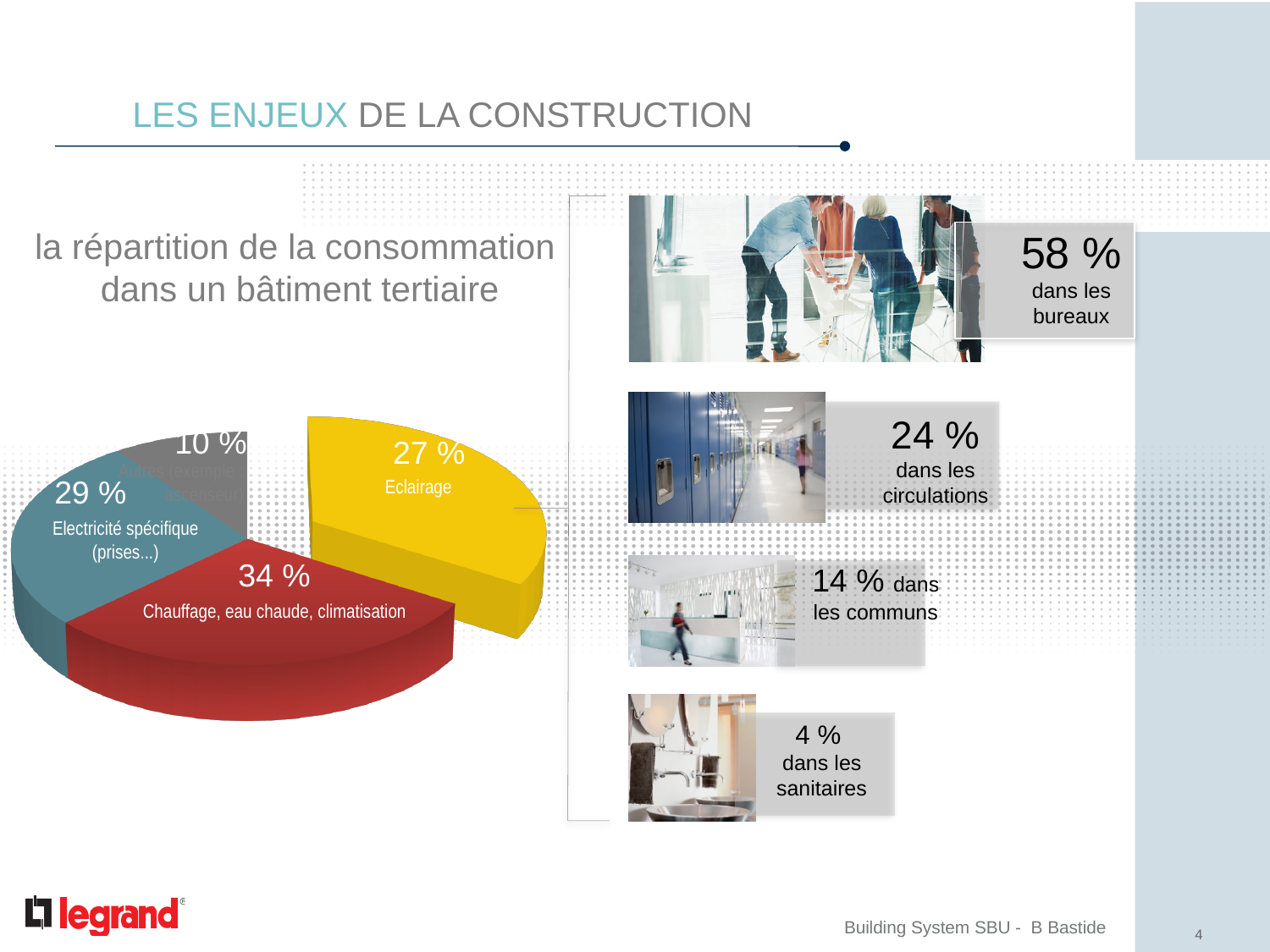
What percentage does the pie chart show for Chauffage, eau chaude, climatisation? 34 % What kind of chart is shown on the slide? pie chart What percentage does the pie chart show for Electricité spécifique (prises...)? 29 % Which is larger in the pie chart: Eclairage or Electricité spécifique (prises...)? Electricité spécifique (prises...) What colour is the Eclairage slice of the pie chart? yellow Which category has the largest slice of the pie chart? Chauffage, eau chaude, climatisation How many slices does the pie chart have? 4 What percentage does the pie chart show for Eclairage? 27 % What is the smallest percentage shown on the pie chart? 10 % What is the difference between the Electricité spécifique (prises...) slice and the Eclairage slice? 2 % What is the title given for the pie chart on the slide? la répartition de la consommation dans un bâtiment tertiaire What is the difference between the Chauffage, eau chaude, climatisation slice and the Eclairage slice? 7 %